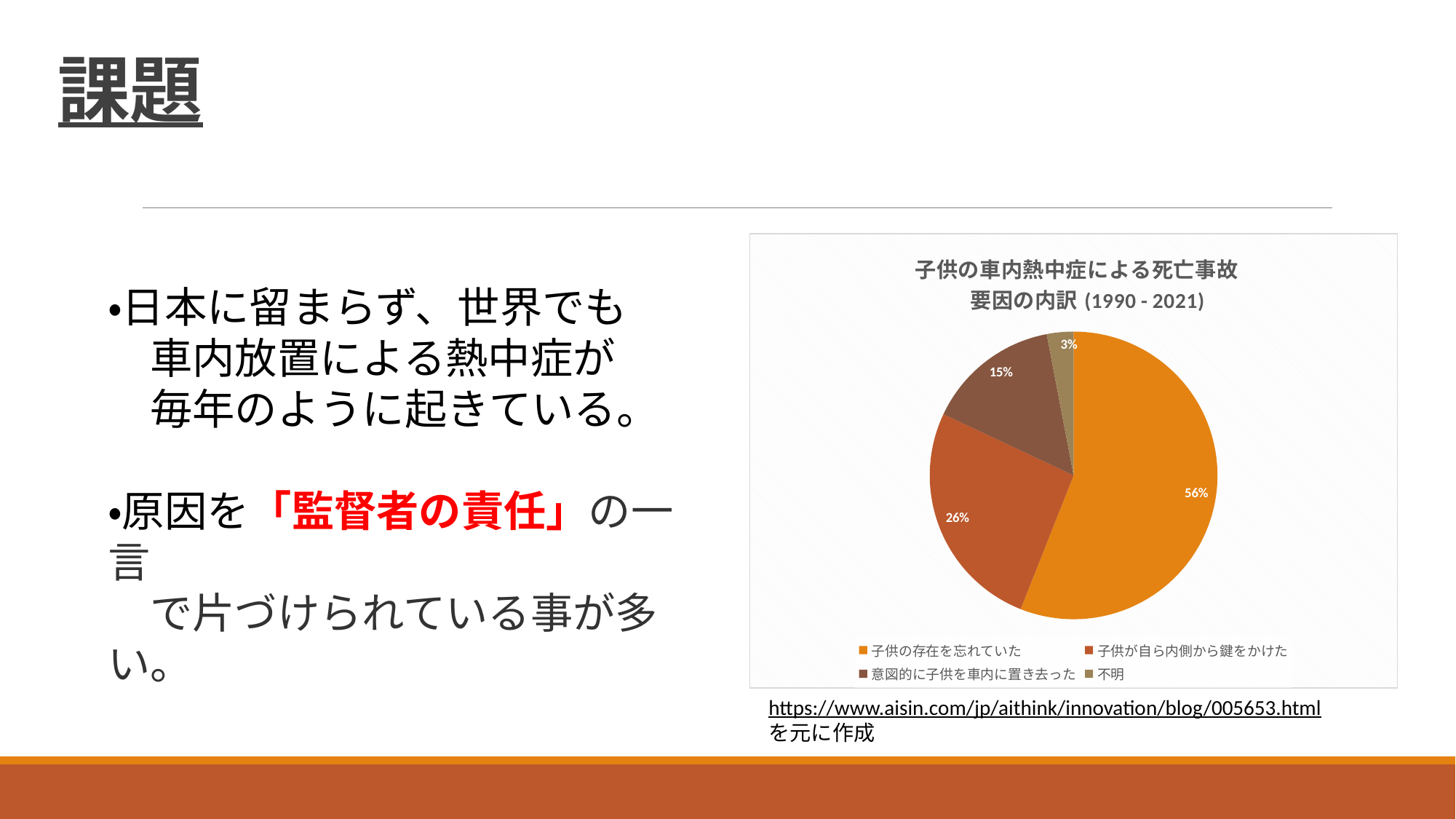
What share of the pie is labelled 子供の存在を忘れていた? 56% What period does the chart title say the data covers? 1990 - 2021 Which category has the largest slice of the pie? 子供の存在を忘れていた What kind of chart is shown on the slide? Pie chart What is the difference in percentage points between 子供の存在を忘れていた and 子供が自ら内側から鍵をかけた? 30% How many categories does the pie chart show? 4 Which is larger: the slice for 意図的に子供を車内に置き去った or the slice for 不明? 意図的に子供を車内に置き去った What share of the pie is labelled 子供が自ら内側から鍵をかけた? 26% Which category has the smallest slice of the pie? 不明 What share of the pie is labelled 意図的に子供を車内に置き去った? 15% What is the title of the pie chart? 子供の車内熱中症による死亡事故 要因の内訳 (1990 - 2021)